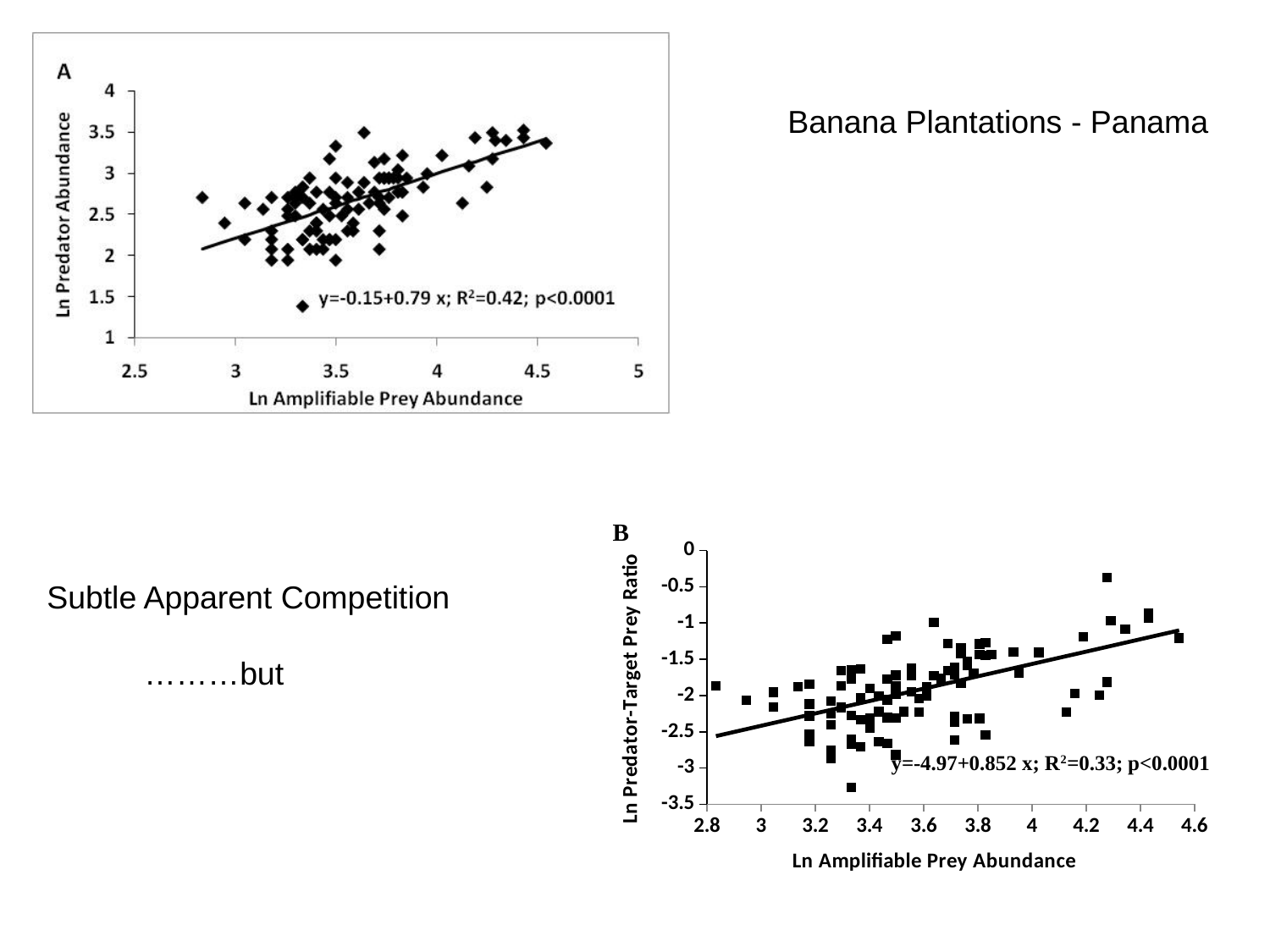
What regression equation is printed on chart B? y=-4.97+0.852 x What is the x-axis label of chart A? Ln Amplifiable Prey Abundance Which chart has the higher R² value, chart A or chart B? Chart A What kind of chart is chart A at the top left of the slide? Scatter plot What is the R² value printed on chart B? 0.33 What is the difference between the R² values of chart A and chart B? 0.09 What kind of chart is chart B at the bottom right of the slide? Scatter plot In chart B, does Ln Predator-Target Prey Ratio tend to rise or fall as Ln Amplifiable Prey Abundance increases? Rise In chart A, does Ln Predator Abundance tend to rise or fall as Ln Amplifiable Prey Abundance increases? Rise What is the y-axis label of chart B? Ln Predator-Target Prey Ratio What regression equation is printed on chart A? y=-0.15+0.79 x What is the R² value printed on chart A? 0.42